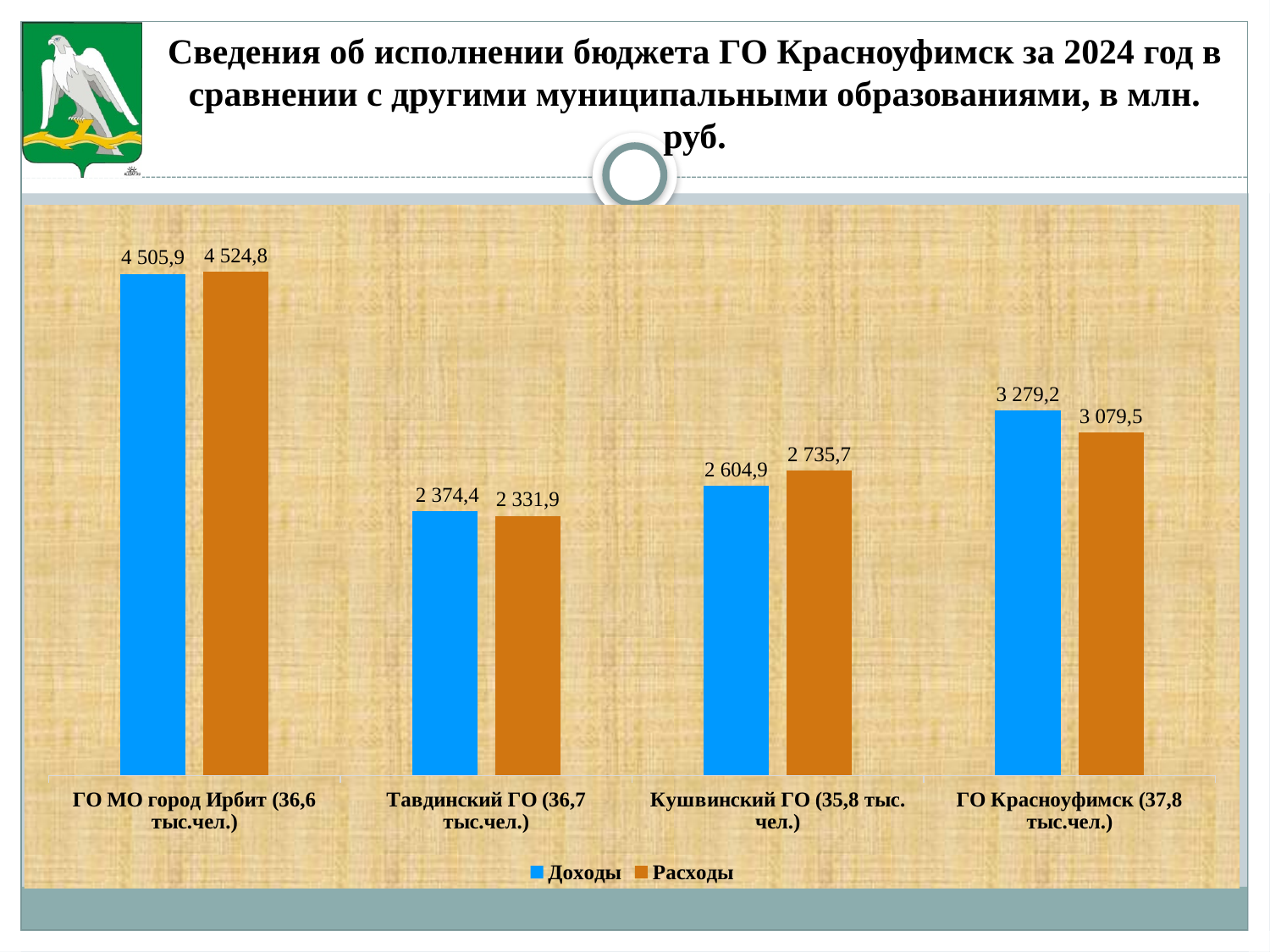
What is the value of Расходы for Кушвинский ГО (35,8 тыс. чел.)? 2 735,7 For Кушвинский ГО (35,8 тыс. чел.), which is larger: Доходы or Расходы? Расходы What is the difference between Доходы and Расходы for ГО Красноуфимск (37,8 тыс.чел.)? 199,7 What is the value of Расходы for ГО МО город Ирбит (36,6 тыс.чел.)? 4 524,8 Which municipality has the highest Доходы value? ГО МО город Ирбит (36,6 тыс.чел.) What is the value of Доходы for ГО Красноуфимск (37,8 тыс.чел.)? 3 279,2 What type of chart is shown on the slide? bar chart How many municipalities (categories) are shown on the x axis? 4 What is the value of Доходы for Тавдинский ГО (36,7 тыс.чел.)? 2 374,4 Which municipality has the lowest Расходы value? Тавдинский ГО (36,7 тыс.чел.) How many series does the legend list? 2 Which colour represents the Расходы series in the legend? orange